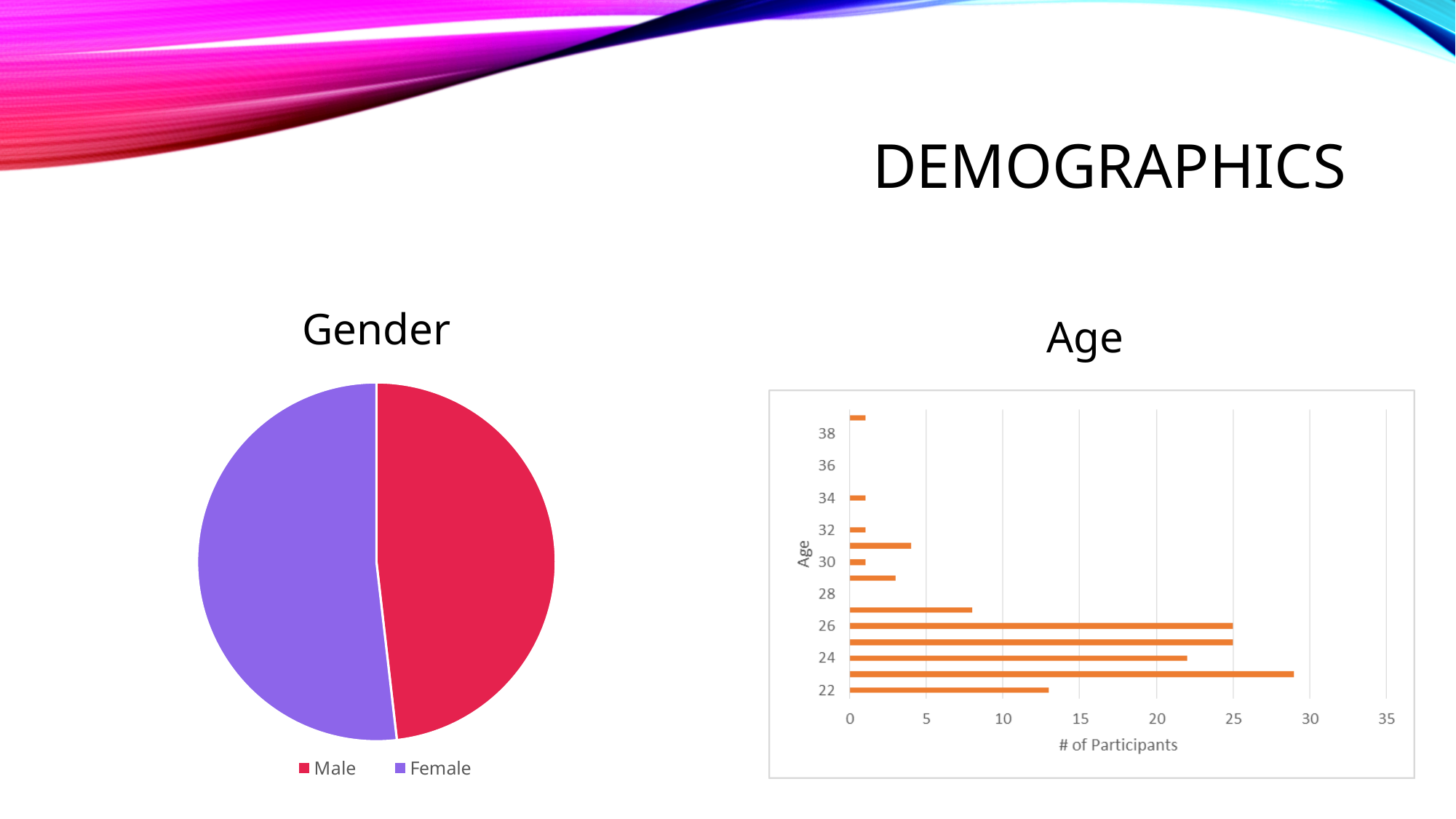
In the Age chart, which has more participants: age 22 or age 23? 23 What kind of chart is the Age chart? bar chart In the Gender chart, what colour is the Female slice? purple In the Age chart, is the number of participants aged 23 greater or less than 25? greater How many entries does the legend of the Gender chart list? 2 In the Age chart, which has more participants: age 24 or age 27? 24 In the Age chart, is the number of participants aged 27 greater or less than 10? less What kind of chart is the Gender chart? pie chart In the Age chart, is the number of participants aged 22 greater or less than 10? greater What is the horizontal axis title of the Age chart? # of Participants In the Age chart, which age has the highest number of participants? 23